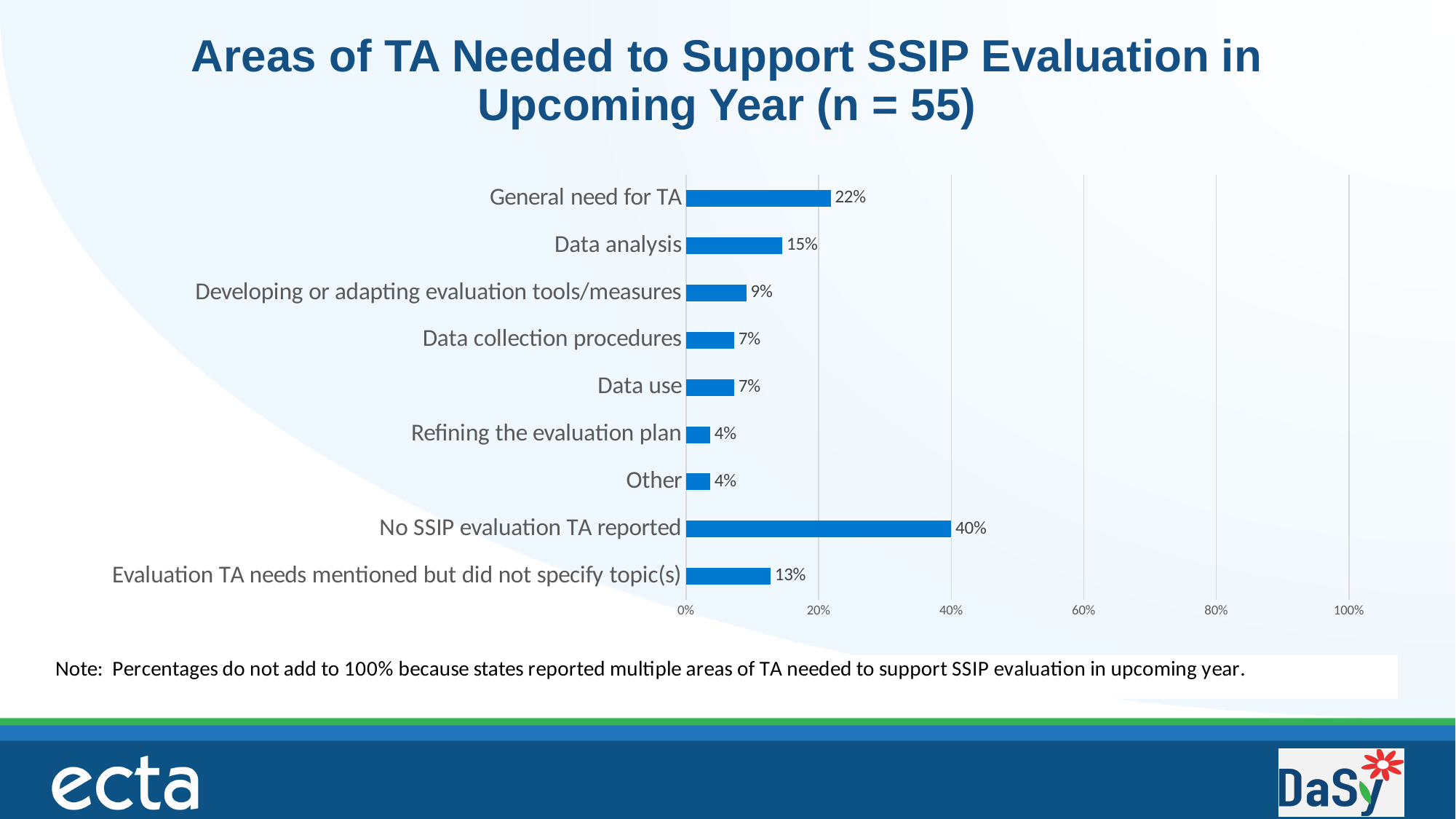
Which is larger, the percentage for Data analysis or for Developing or adapting evaluation tools/measures? Data analysis How many categories are shown in the chart? 9 Is the value for No SSIP evaluation TA reported greater or less than 20%? greater What percentage is shown for No SSIP evaluation TA reported? 40% What is the difference between the percentages for Data analysis and Refining the evaluation plan? 11% What kind of chart is shown on the slide? Bar chart Which category has the highest percentage? No SSIP evaluation TA reported What is the sample size (n) given in the chart title? 55 What percentage is shown for General need for TA? 22% What percentage is shown for Evaluation TA needs mentioned but did not specify topic(s)? 13% What percentage is shown for Data analysis? 15% What is the difference between the percentages for No SSIP evaluation TA reported and General need for TA? 18%